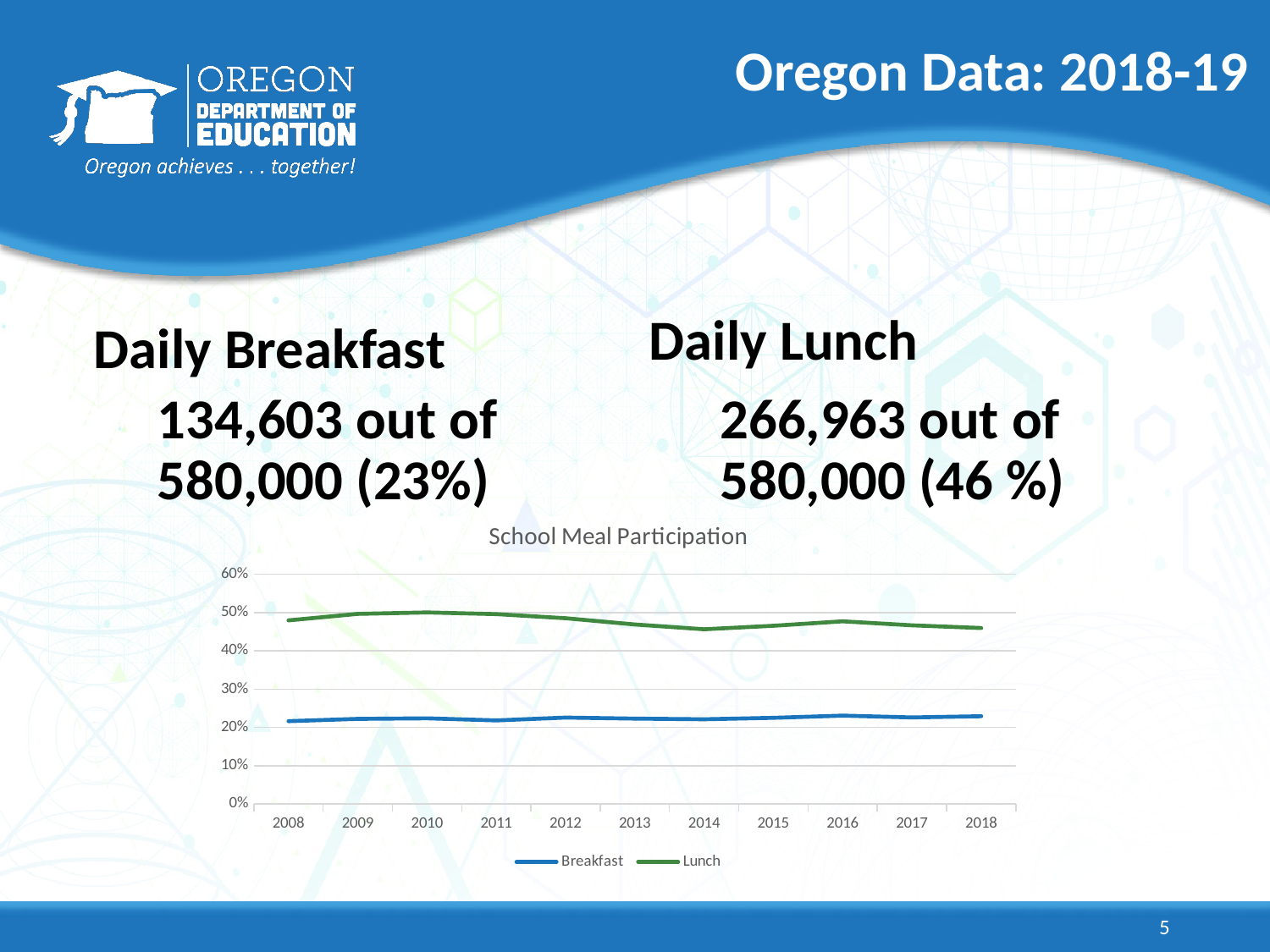
How many series does the chart legend list? 2 What kind of chart is shown on the slide? line chart Is the Breakfast value for 2018 greater or less than 30%? less Which series is drawn in green in the chart? Lunch Does the Lunch series rise or fall between 2010 and 2014? fall Is the Lunch value for 2014 greater or less than 40%? greater In 2018, which series has the higher value, Breakfast or Lunch? Lunch Is the Lunch value for 2018 greater or less than 50%? less Which year is the first point on the x axis of the chart? 2008 How many years are plotted along the x axis of the chart? 11 What is the title of the chart? School Meal Participation